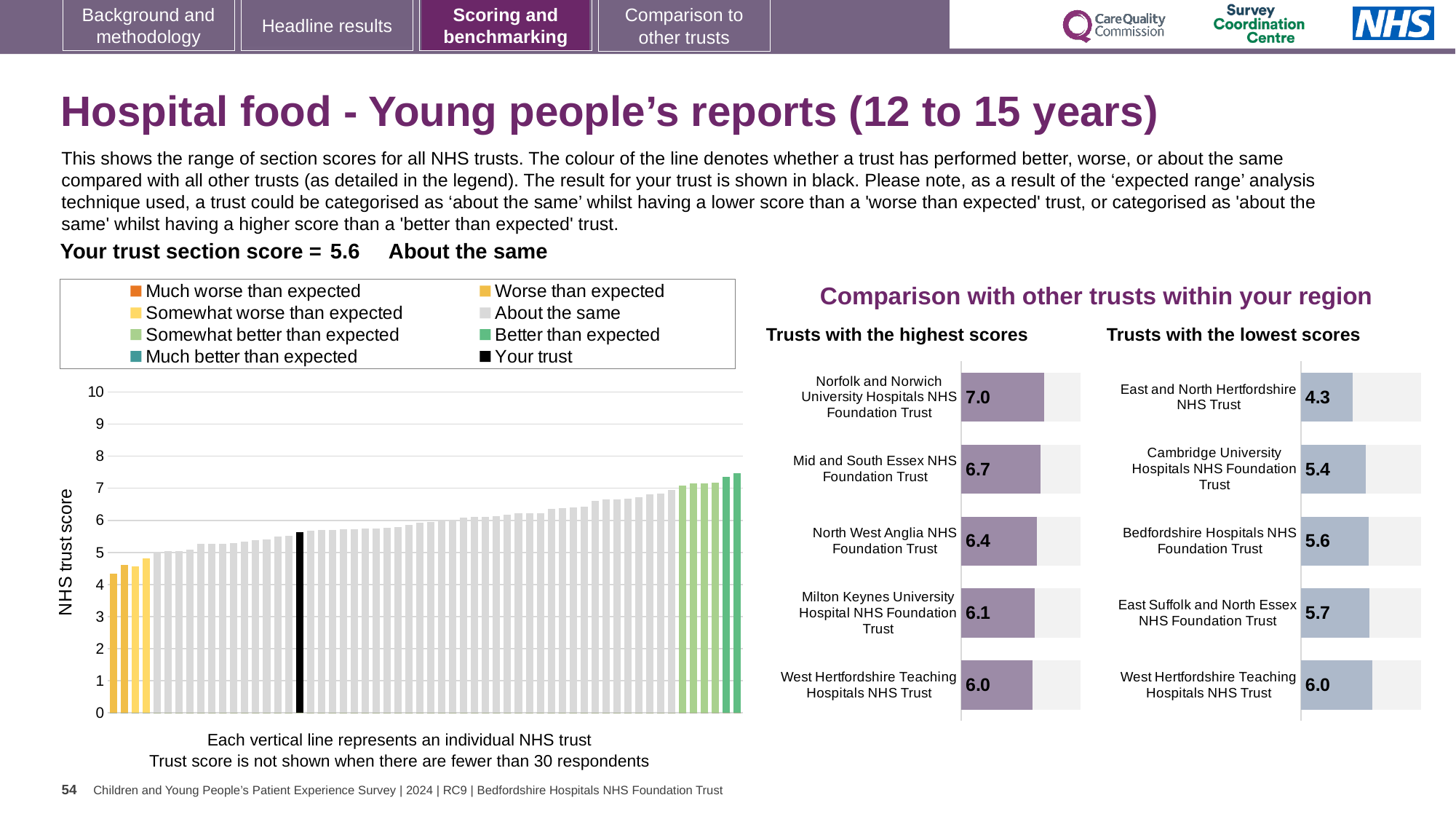
How many entries does the legend of the NHS trust score chart on the left list? 8 In the 'Trusts with the lowest scores' chart, which has the larger score: Cambridge University Hospitals NHS Foundation Trust or Bedfordshire Hospitals NHS Foundation Trust? Bedfordshire Hospitals NHS Foundation Trust In the 'Trusts with the highest scores' chart, which trust has the lowest score? West Hertfordshire Teaching Hospitals NHS Trust In the 'Trusts with the lowest scores' chart, what is the score for Bedfordshire Hospitals NHS Foundation Trust? 5.6 What kind of chart is the NHS trust score chart on the left of the slide? Bar chart In the 'Trusts with the highest scores' chart, what is the score for Norfolk and Norwich University Hospitals NHS Foundation Trust? 7.0 In the 'Trusts with the lowest scores' chart, which trust has the highest score? West Hertfordshire Teaching Hospitals NHS Trust In the 'Trusts with the lowest scores' chart, what is the score for East and North Hertfordshire NHS Trust? 4.3 In the 'Trusts with the highest scores' chart, what is the difference between the scores of Norfolk and Norwich University Hospitals NHS Foundation Trust and Mid and South Essex NHS Foundation Trust? 0.3 In the NHS trust score chart on the left, do the values rise or fall from left to right? Rise In the NHS trust score chart on the left, is the value of the black bar (your trust) greater or less than 6? less How many trusts are shown in the 'Trusts with the lowest scores' chart? 5